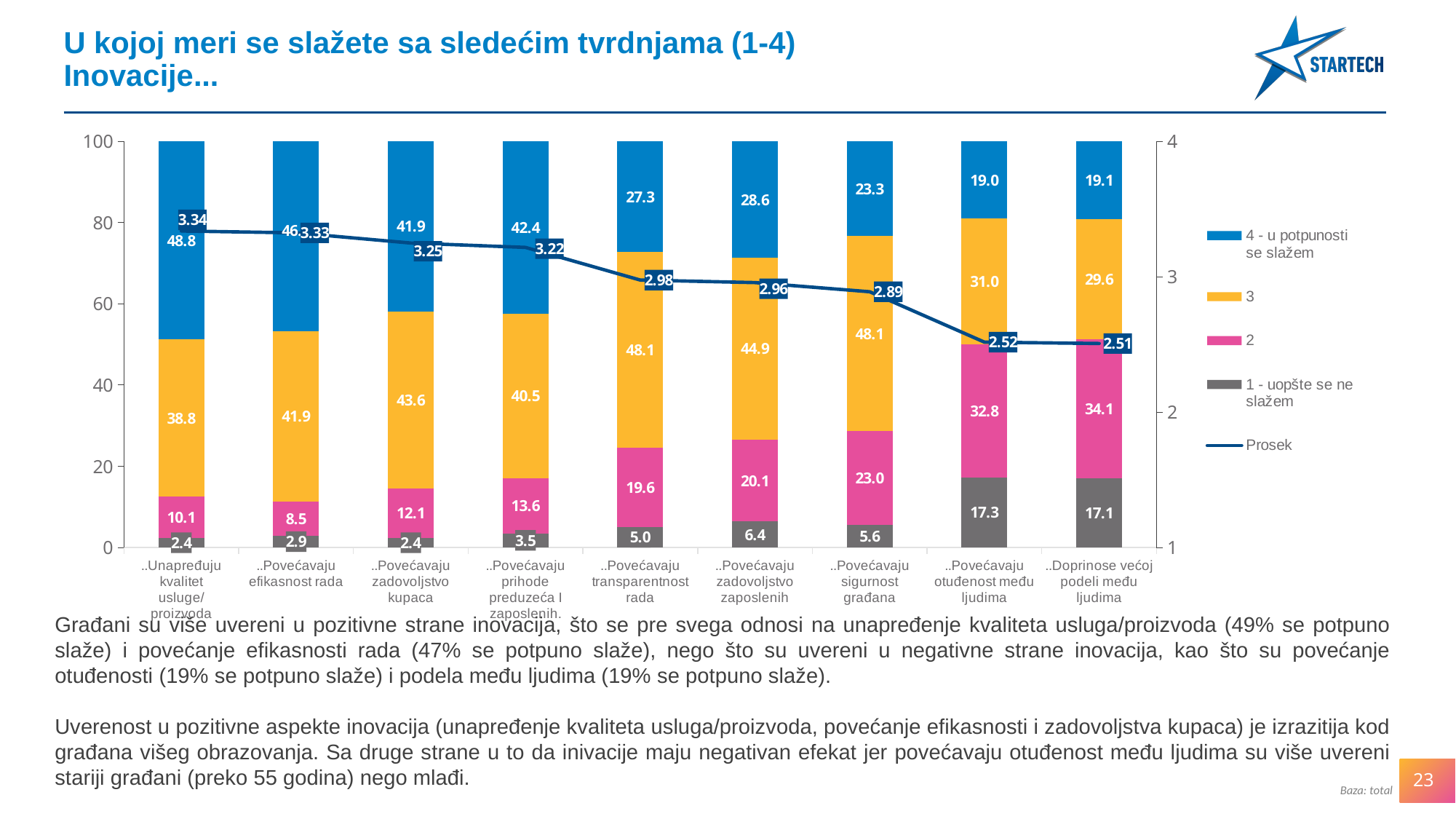
What kind of chart is this? Stacked bar chart with a line Which is larger: the series '3' value for '..Povećavaju zadovoljstvo kupaca' or for '..Povećavaju prihode preduzeća i zaposlenih'? ..Povećavaju zadovoljstvo kupaca What is the value of series '2' for '..Doprinose većoj podeli među ljudima'? 34.1 Which category has the lowest value for the '4 - u potpunosti se slažem' series? ..Povećavaju otuđenost među ljudima How many entries does the legend list? 5 What is the value of the '4 - u potpunosti se slažem' series for '..Unapređuju kvalitet usluge/proizvoda'? 48.8 What is the difference between the '1 - uopšte se ne slažem' values for '..Povećavaju otuđenost među ljudima' and '..Povećavaju transparentnost rada'? 12.3 What is the Prosek value for '..Povećavaju zadovoljstvo zaposlenih'? 2.96 How many categories are shown on the x axis? 9 What is the Prosek (average) value for '..Povećavaju sigurnost građana'? 2.89 Which category has the highest Prosek value? ..Unapređuju kvalitet usluge/proizvoda Does the Prosek line rise or fall from left to right across the categories? Fall